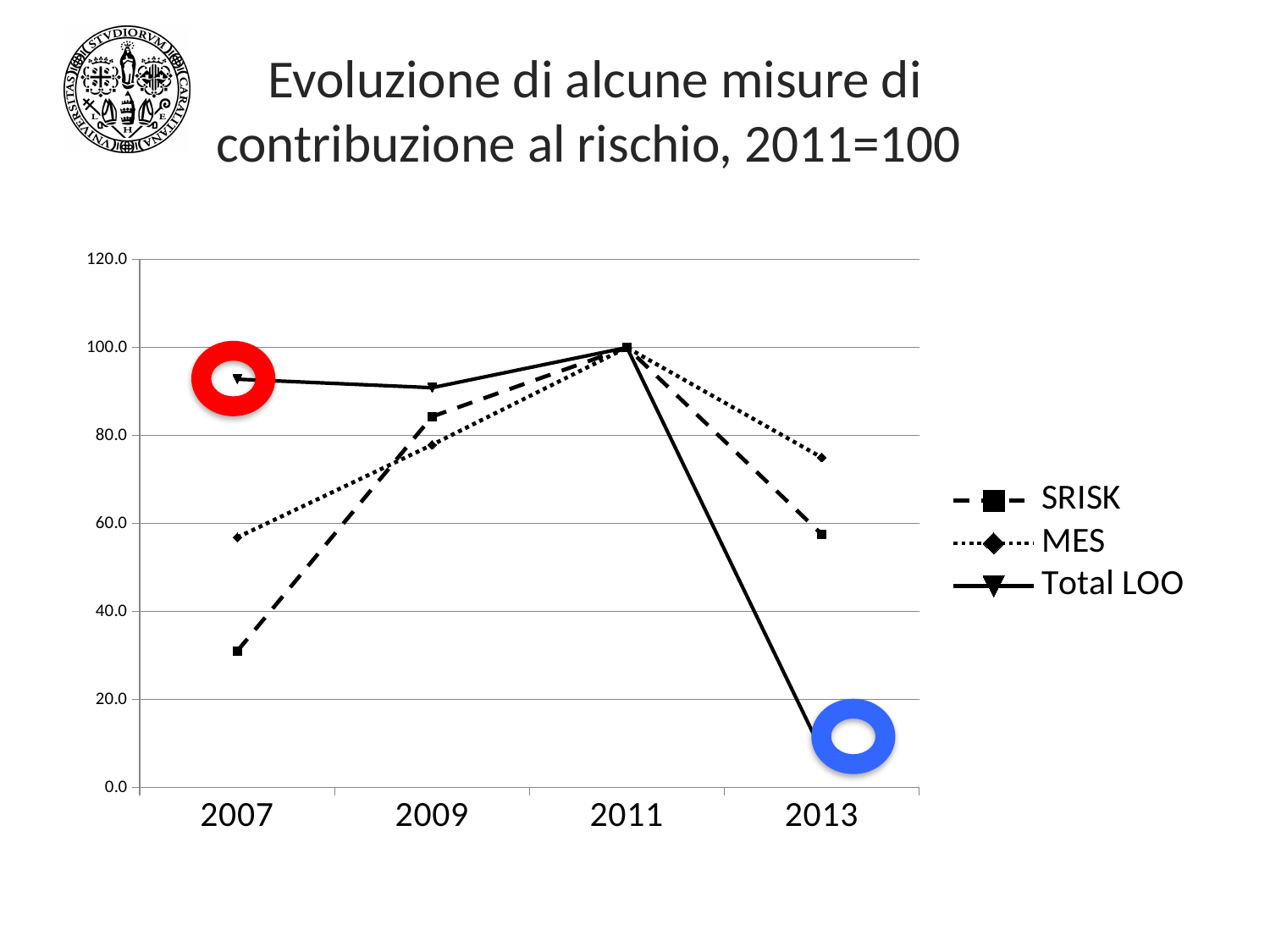
How many series does the legend list? 3 In 2007, which is larger: SRISK or MES? MES Is the value for Total LOO in 2007 greater or less than 80? greater Is the value for Total LOO in 2013 greater or less than 20? less Which series has the lowest value in 2007? SRISK Which series has the highest value in 2013? MES Does the Total LOO series rise or fall from 2011 to 2013? fall What kind of chart is shown on the slide? line chart Is the value for MES in 2013 greater or less than 80? less How many years are shown on the x axis? 4 What is the value of Total LOO in 2011? 100.0